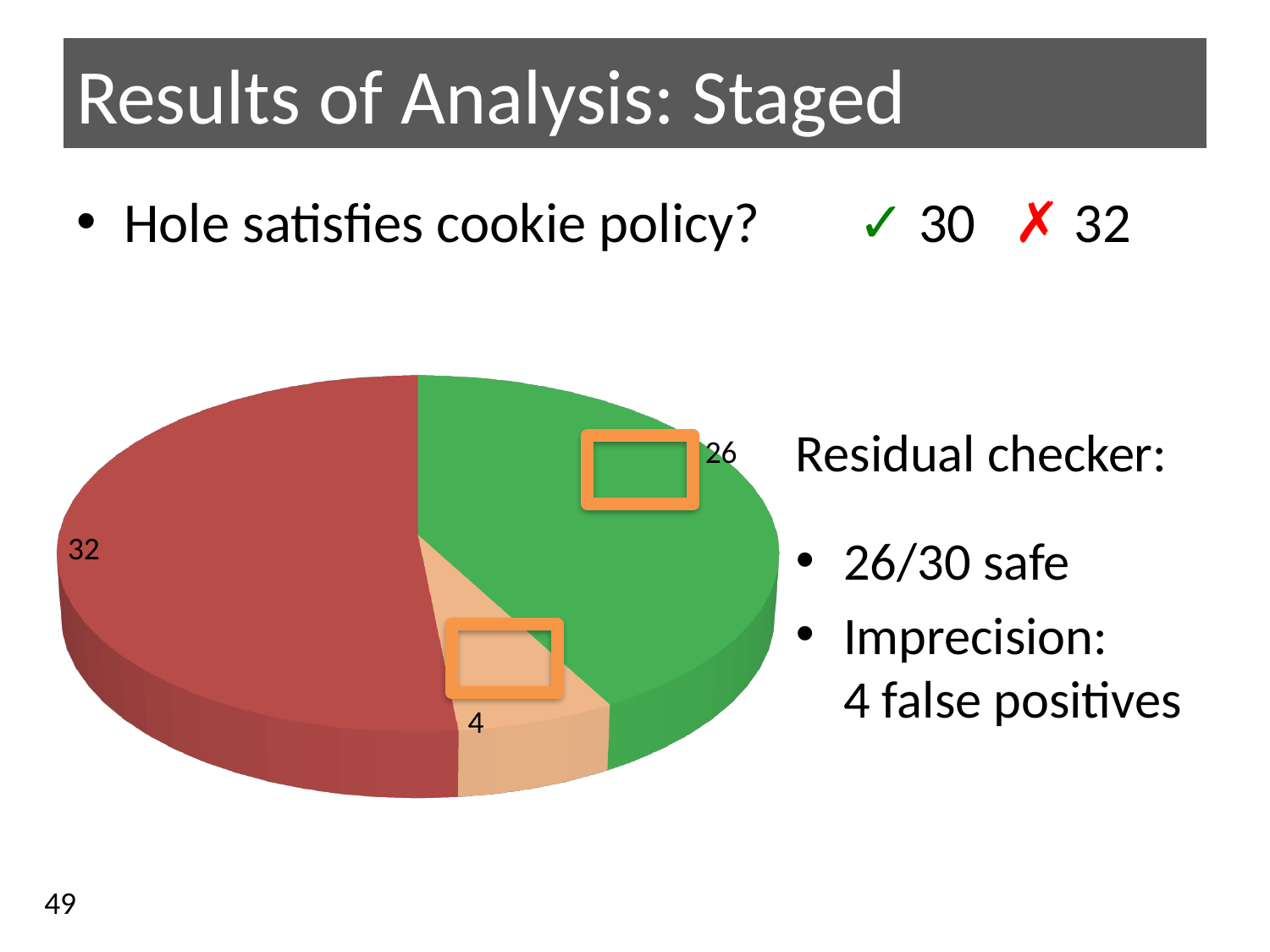
Does the pie chart have a legend? No What is the value of the green slice of the pie chart? 26 Which is larger in the pie chart, the green slice or the tan slice? the green slice What is the value of the red slice of the pie chart? 32 What is the total of all the slice values in the pie chart? 62 What is the difference between the green slice and the tan slice of the pie chart? 22 What is the difference between the red slice and the green slice of the pie chart? 6 How many slices does the pie chart have? 3 Which slice of the pie chart has the smallest value? the tan slice (4) What kind of chart is shown on the slide? pie chart Which slice of the pie chart has the largest value? the red slice (32) What is the value of the small tan slice of the pie chart? 4